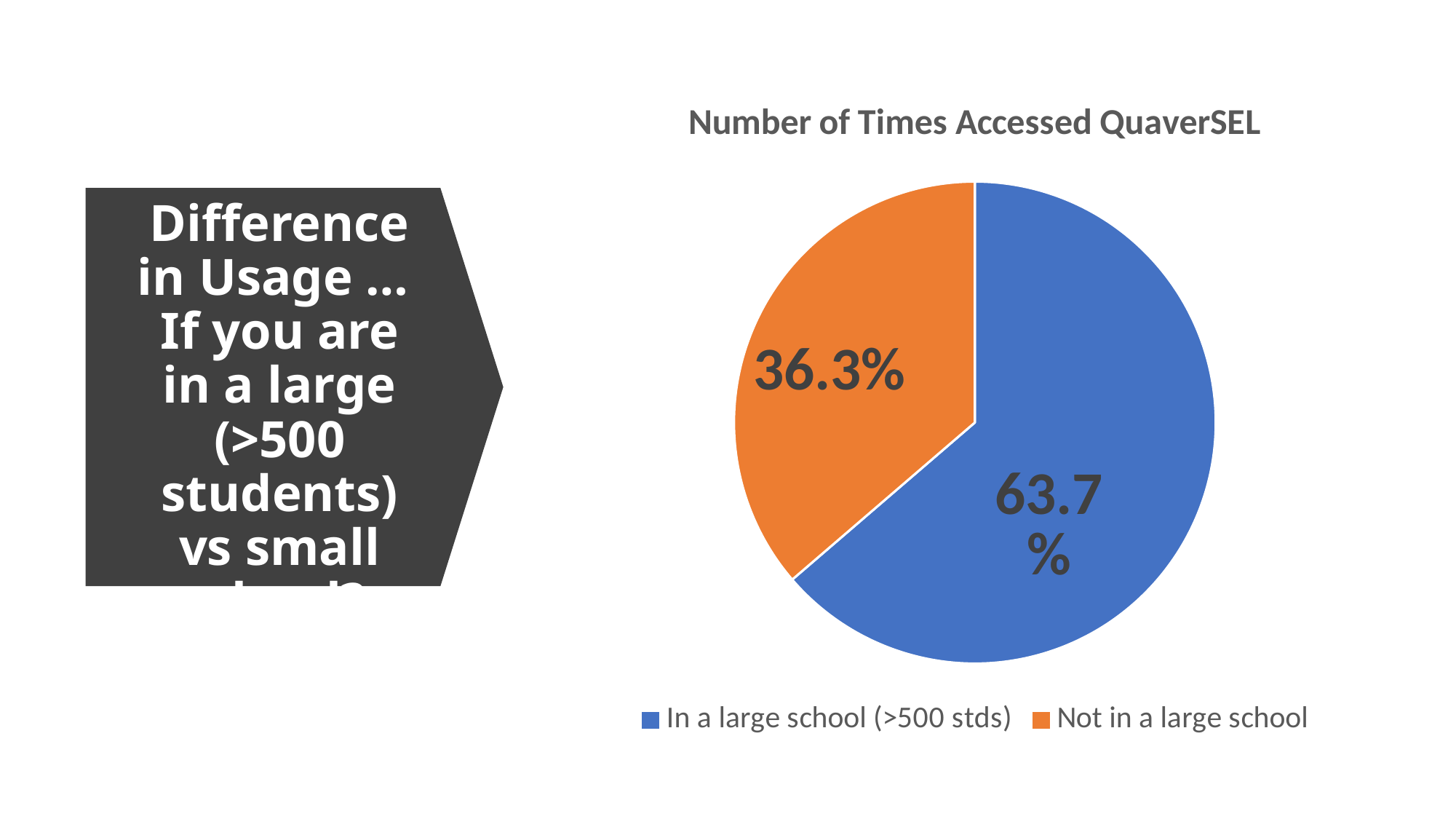
What share of the pie is labelled for 'In a large school (>500 stds)'? 63.7% What type of chart is shown on the slide? pie chart Which category has the largest slice of the pie? In a large school (>500 stds) What colour is the slice for 'Not in a large school'? orange Is the share for 'In a large school (>500 stds)' greater or less than 50%? greater What is the title of the chart? Number of Times Accessed QuaverSEL Which category has the smallest slice of the pie? Not in a large school What share of the pie is labelled for 'Not in a large school'? 36.3% How many slices does the pie chart have? 2 Which slice is larger: 'In a large school (>500 stds)' or 'Not in a large school'? In a large school (>500 stds) What is the difference in percentage points between the 'In a large school (>500 stds)' slice and the 'Not in a large school' slice? 27.4 How many entries does the legend list? 2